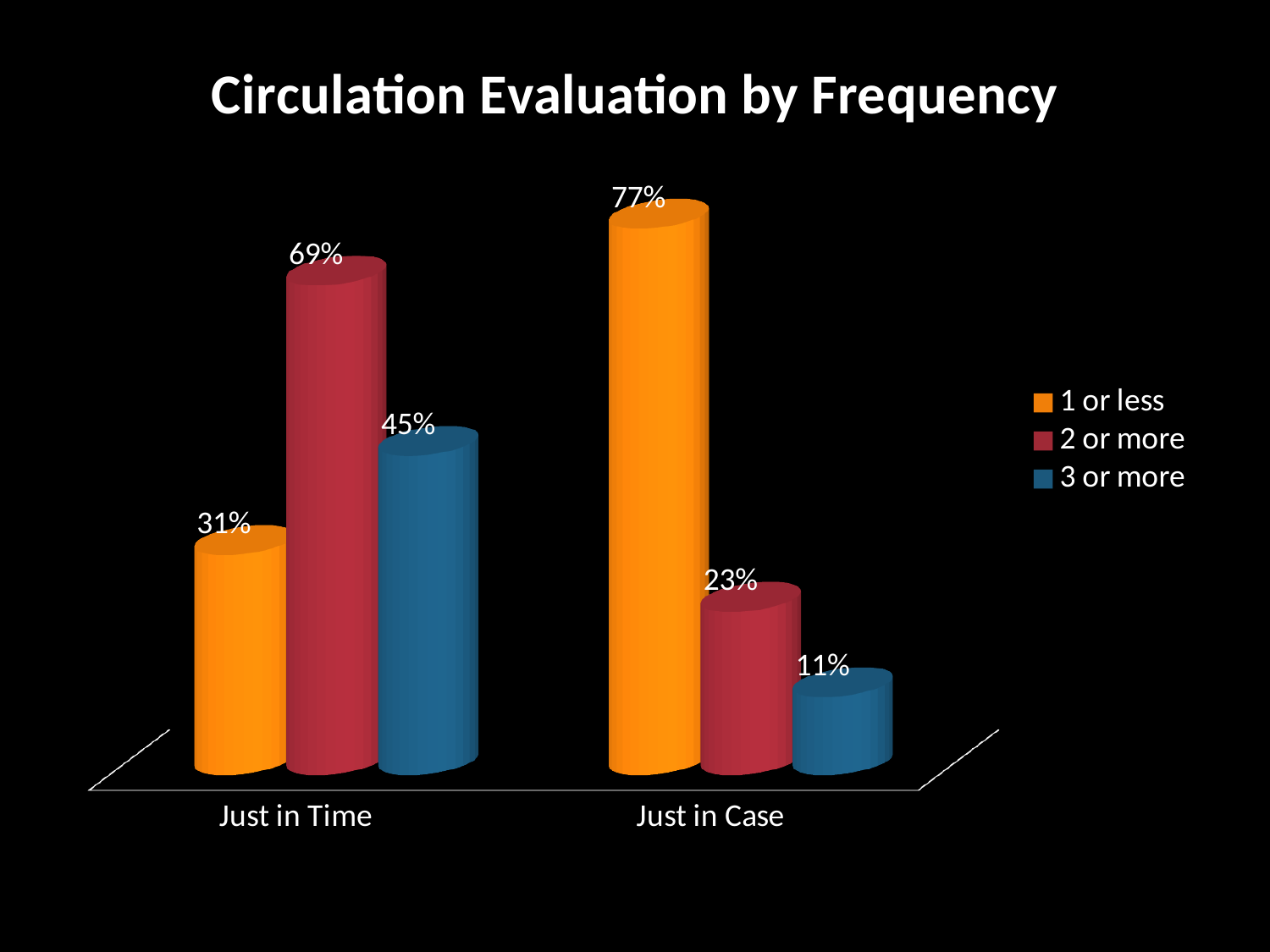
What is the difference between the "2 or more" values for Just in Time and Just in Case? 46% Which is larger: the "3 or more" value for Just in Time or for Just in Case? Just in Time Which series has the highest value in the Just in Case category? 1 or less Which series has the lowest value in the Just in Time category? 1 or less How many series does the legend list? 3 What is the value for "1 or less" in the Just in Case category? 77% What is the value for "3 or more" in the Just in Case category? 11% What is the value for "1 or less" in the Just in Time category? 31% What is the title of the chart? Circulation Evaluation by Frequency What kind of chart is shown on the slide? Bar chart How many categories are shown on the x axis? 2 What is the value for "2 or more" in the Just in Time category? 69%